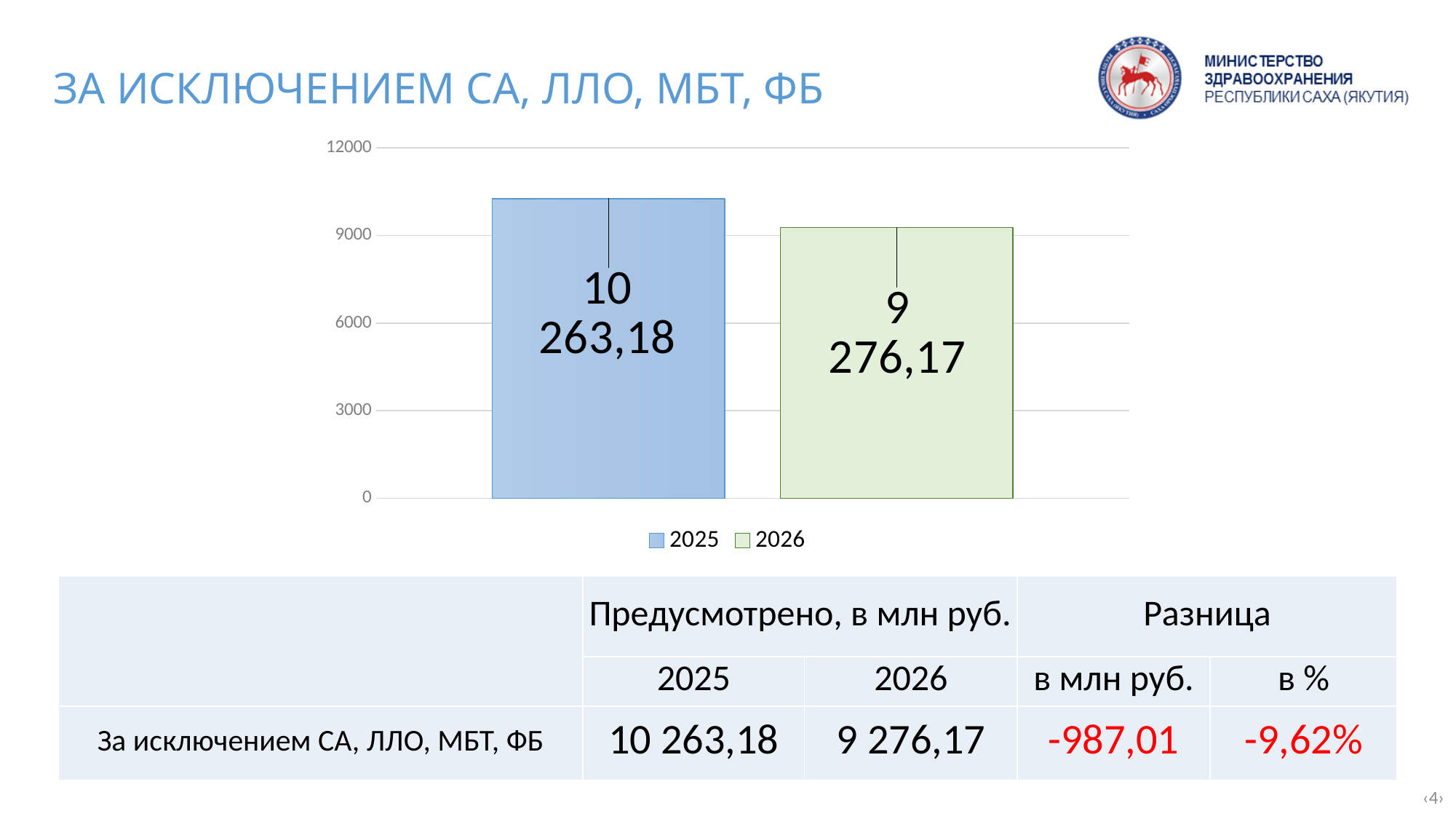
Is the value for 2026 greater or less than 12000? less How many series does the chart legend list? 2 What is the value shown for 2025 on the chart? 10 263,18 What is the difference between the 2025 value and the 2026 value on the chart? 987,01 Which series has the highest value on the chart? 2025 Which series has the lowest value on the chart? 2026 What is the value shown for 2026 on the chart? 9 276,17 Is the value for 2025 greater or less than 9000? greater Do the values fall or rise from 2025 to 2026 on the chart? fall What kind of chart is shown on the slide? bar chart Which year has the higher value on the chart, 2025 or 2026? 2025 What colour is the bar for 2026 in the chart? green